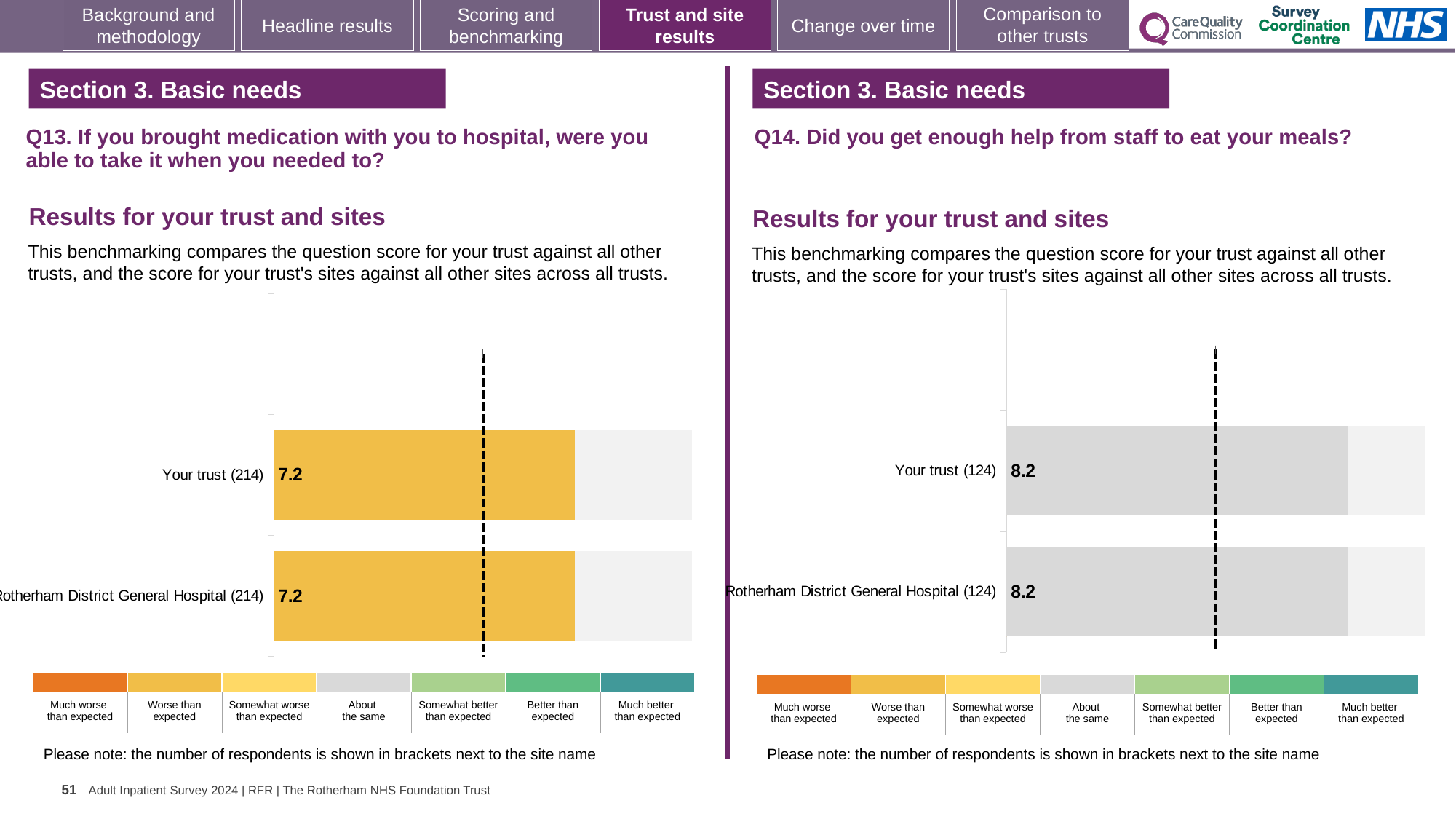
How many bars are plotted on the Q13 chart (left)? 2 What kind of chart is used on the Q13 chart (left)? Bar chart On the Q14 chart (right), how many respondents are shown in brackets for Rotherham District General Hospital? 124 According to the colour key, which benchmark category do the grey bars on the Q14 chart (right) represent? About the same How many bars are plotted on the Q14 chart (right)? 2 On the Q14 chart (right), what is the score for Your trust (124)? 8.2 On the Q13 chart (left), what is the score for Your trust (214)? 7.2 On the Q13 chart (left), how many respondents are shown in brackets for Your trust? 214 On the Q13 chart (left), what is the score for Rotherham District General Hospital (214)? 7.2 On the Q14 chart (right), what is the difference between the score for Your trust and the score for Rotherham District General Hospital? 0.0 On the Q14 chart (right), what is the score for Rotherham District General Hospital (124)? 8.2 On the Q13 chart (left), what is the difference between the score for Your trust and the score for Rotherham District General Hospital? 0.0